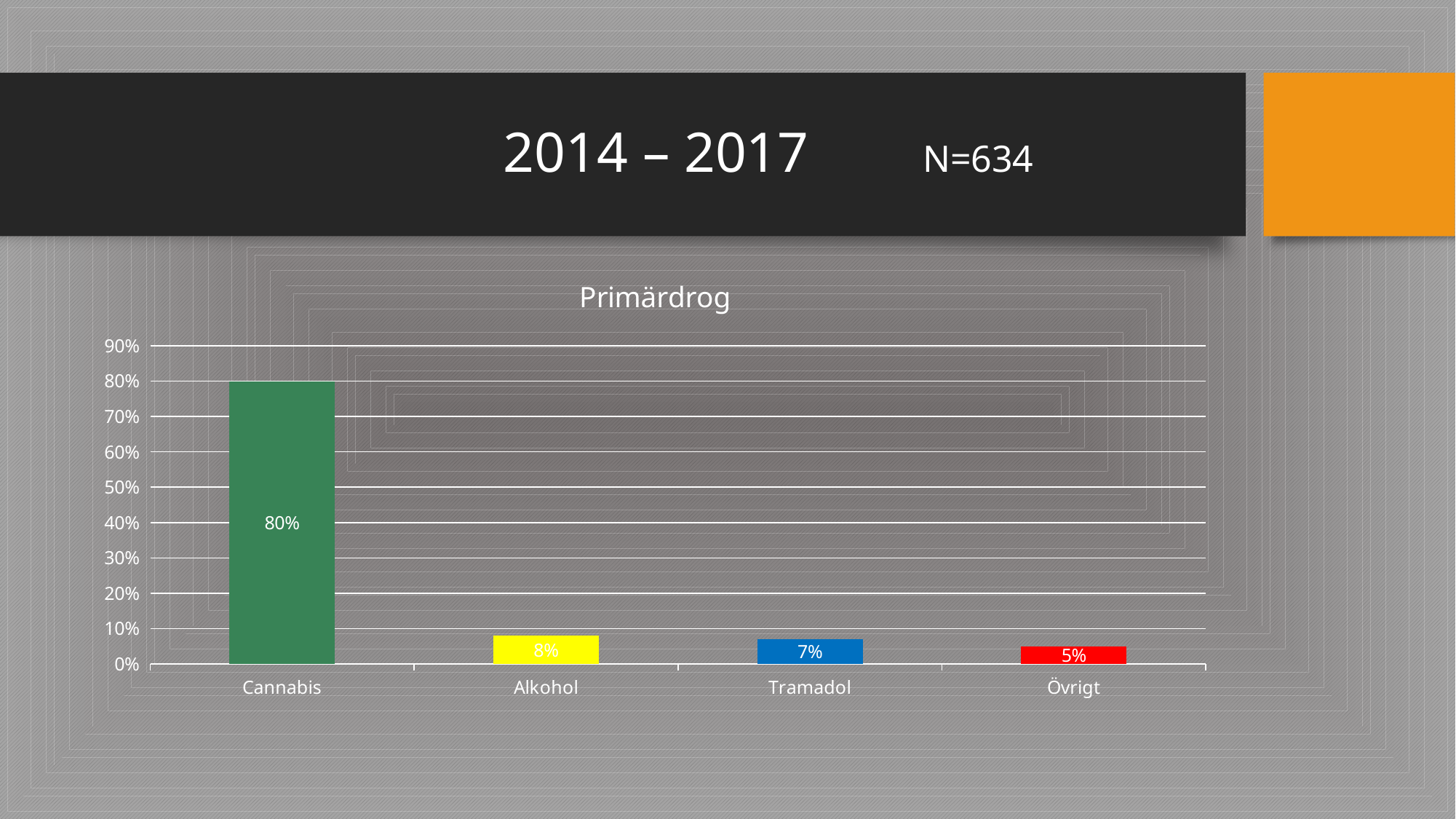
Which category has the lowest value? Övrigt What is the title of the chart? Primärdrog How many categories are shown on the x axis? 4 Which is larger, the value for Alkohol or the value for Övrigt? Alkohol What is the difference between the values for Tramadol and Övrigt? 2% Which category has the highest value? Cannabis What is the value for Tramadol? 7% What is the value for Alkohol? 8% What is the difference between the values for Cannabis and Alkohol? 72% What is the value for Cannabis? 80% What kind of chart is shown on the slide? Bar chart What is the value for Övrigt? 5%